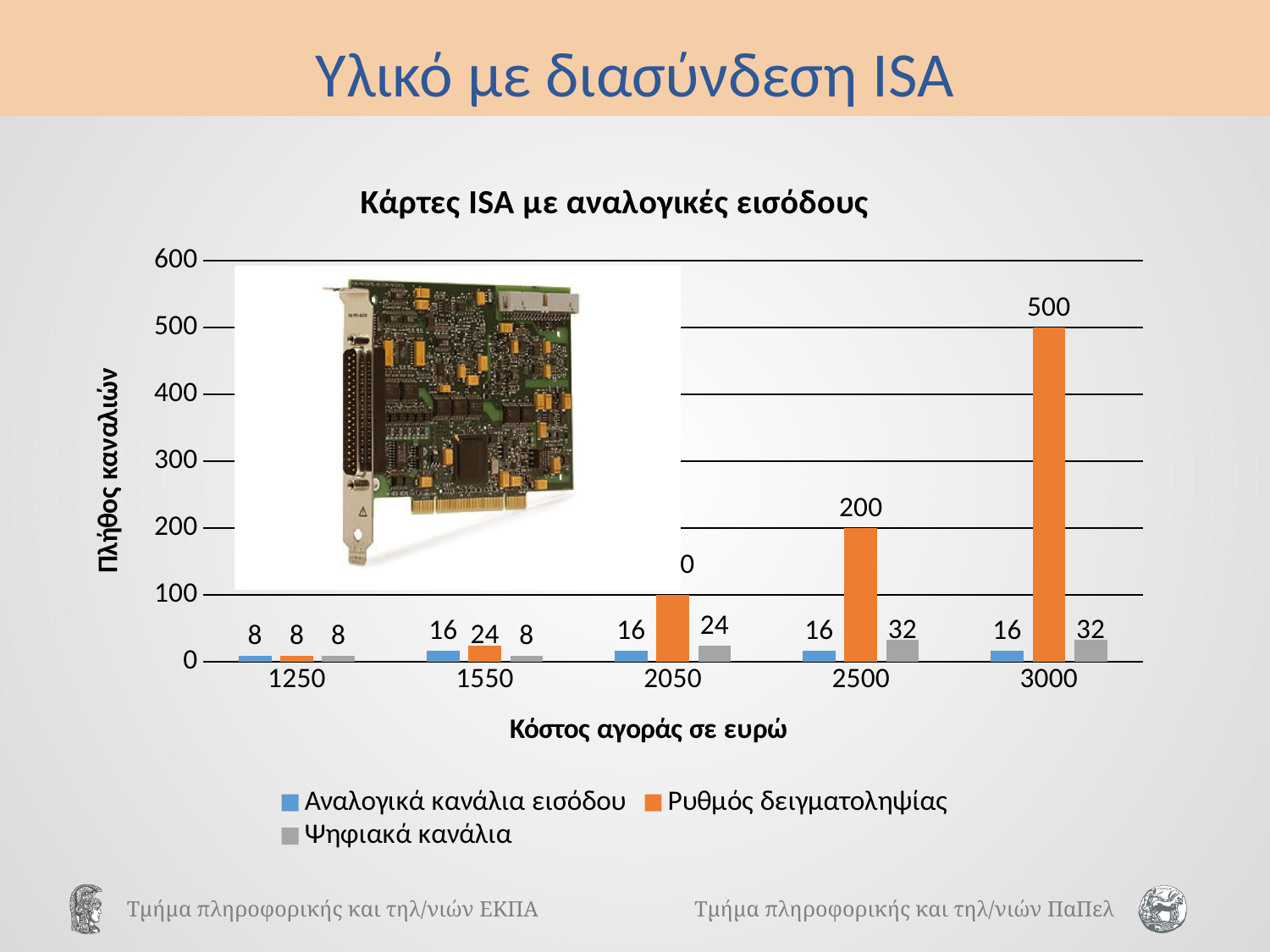
What is the value of Αναλογικά κανάλια εισόδου for the 1550 cost category? 16 Which is larger: Ψηφιακά κανάλια for 1550 or for 2050? 2050 Is the value of Ρυθμός δειγματοληψίας for the 2050 cost category greater or less than 200? less What is the value of Ρυθμός δειγματοληψίας for the 3000 cost category? 500 What kind of chart is shown on the slide? bar chart How many series does the legend list? 3 What is the difference between the Ρυθμός δειγματοληψίας values for the 3000 and 2500 cost categories? 300 What is the value of Ψηφιακά κανάλια for the 2500 cost category? 32 What is the value of Ρυθμός δειγματοληψίας for the 1550 cost category? 24 Does the Ρυθμός δειγματοληψίας series rise or fall as the cost increases along the x axis? rise Which cost category has the highest Ρυθμός δειγματοληψίας? 3000 How many cost categories are shown on the x axis? 5